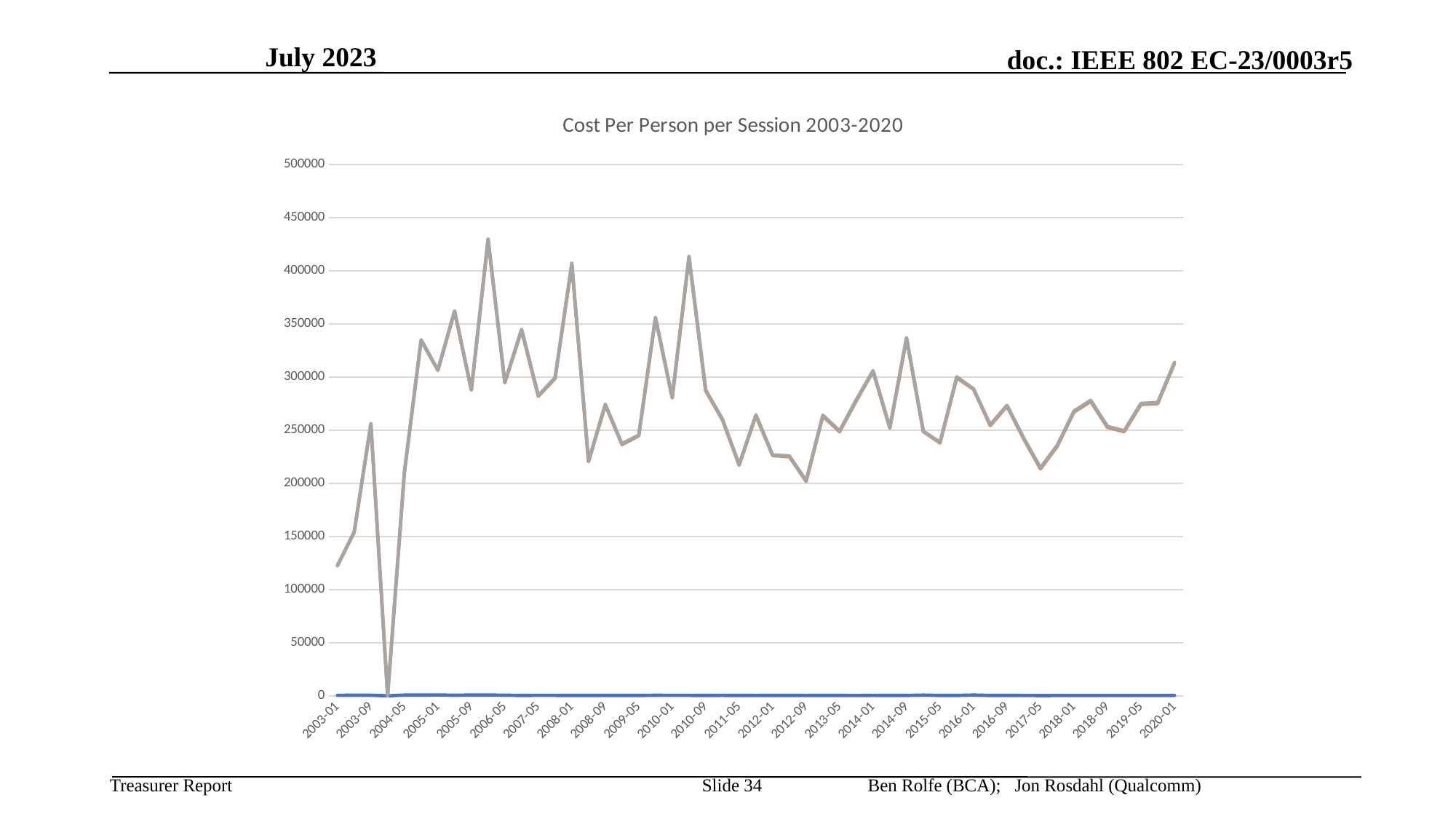
Is the value for 2005-01 greater or less than 300000? greater Do the values rise or fall from 2017-05 to 2020-01? rise What is the title of the chart? Cost Per Person per Session 2003-2020 What kind of chart is shown on the slide? line chart What is the highest value shown on the y axis? 500000 Is the value for 2003-01 greater or less than 150000? less Is the value for 2010-09 greater or less than 350000? less Which has the larger value, 2003-01 or 2005-01? 2005-01